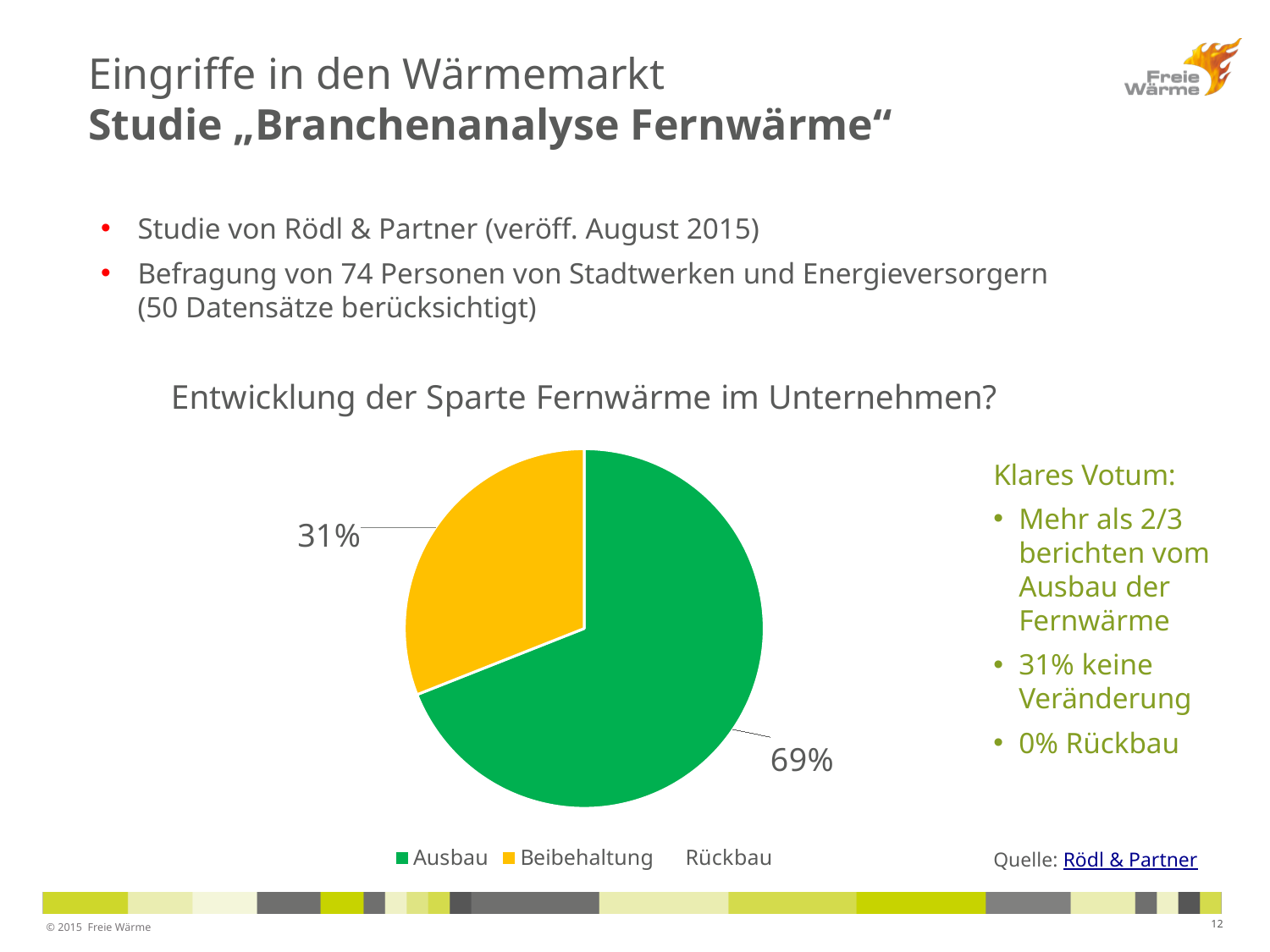
Which legend entry has no visible slice in the pie? Rückbau Which of the two visible slices is larger, Ausbau or Beibehaltung? Ausbau What is the difference in percentage points between the Ausbau and Beibehaltung slices? 38 Is the share for Beibehaltung greater or less than 50%? less What share of the pie does Ausbau have? 69% What is the title of the chart? Entwicklung der Sparte Fernwärme im Unternehmen? What share of the pie does Beibehaltung have? 31% Which category has the largest slice of the pie? Ausbau What colour is the Ausbau slice? green How many entries does the legend list? 3 What kind of chart is shown on the slide? pie chart